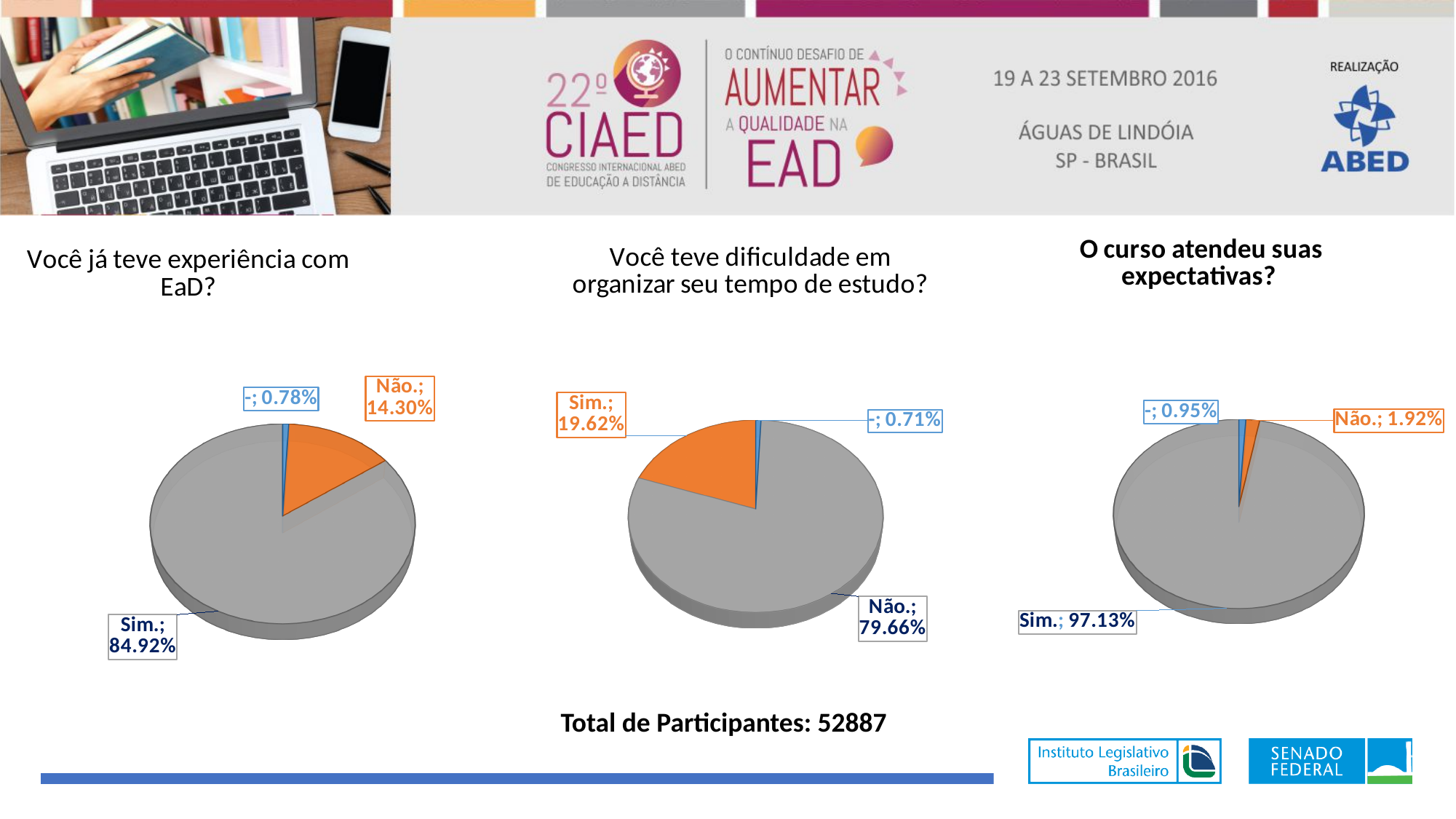
In the chart titled 'Você já teve experiência com EaD?', what is the share for 'Não.'? 14.30% In the chart titled 'Você teve dificuldade em organizar seu tempo de estudo?', what is the share for 'Não.'? 79.66% What kind of chart is used for 'Você teve dificuldade em organizar seu tempo de estudo?'? Pie chart In the chart titled 'O curso atendeu suas expectativas?', which is larger, 'Não.' or '-'? Não. In the chart titled 'Você já teve experiência com EaD?', what is the share for 'Sim.'? 84.92% In the chart titled 'Você já teve experiência com EaD?', which category has the largest slice? Sim. In the chart titled 'Você teve dificuldade em organizar seu tempo de estudo?', which category has the smallest slice? - In the chart titled 'Você já teve experiência com EaD?', what is the difference between the 'Sim.' and 'Não.' shares? 70.62% In the chart titled 'O curso atendeu suas expectativas?', what is the share for 'Não.'? 1.92% In the chart titled 'Você teve dificuldade em organizar seu tempo de estudo?', what is the share for 'Sim.'? 19.62% In the chart titled 'O curso atendeu suas expectativas?', what is the share for 'Sim.'? 97.13% How many slices does the chart titled 'O curso atendeu suas expectativas?' have? 3